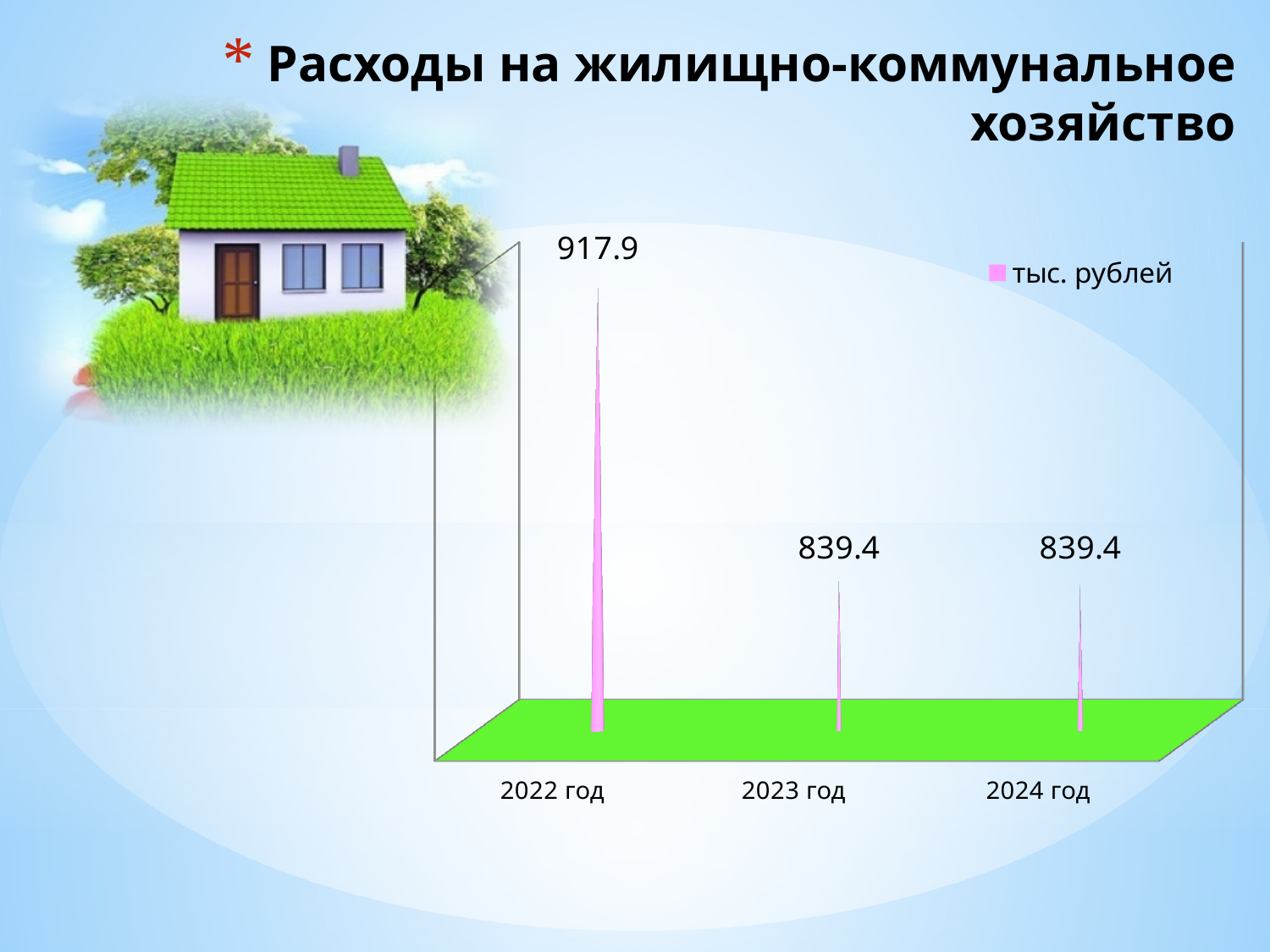
What is the value for 2024 год? 839.4 Are the values for 2023 год and 2024 год equal? Yes Do the values rise or fall from 2022 год to 2023 год? Fall What is the value for 2023 год? 839.4 How many years are shown on the chart? 3 How many series does the legend list? 1 What is the value for 2022 год? 917.9 What kind of chart is shown on the slide? Bar chart Which year has the highest value? 2022 год Which is larger, the value for 2022 год or the value for 2024 год? 2022 год What is the legend entry of the chart? тыс. рублей What is the difference between the values for 2022 год and 2023 год? 78.5